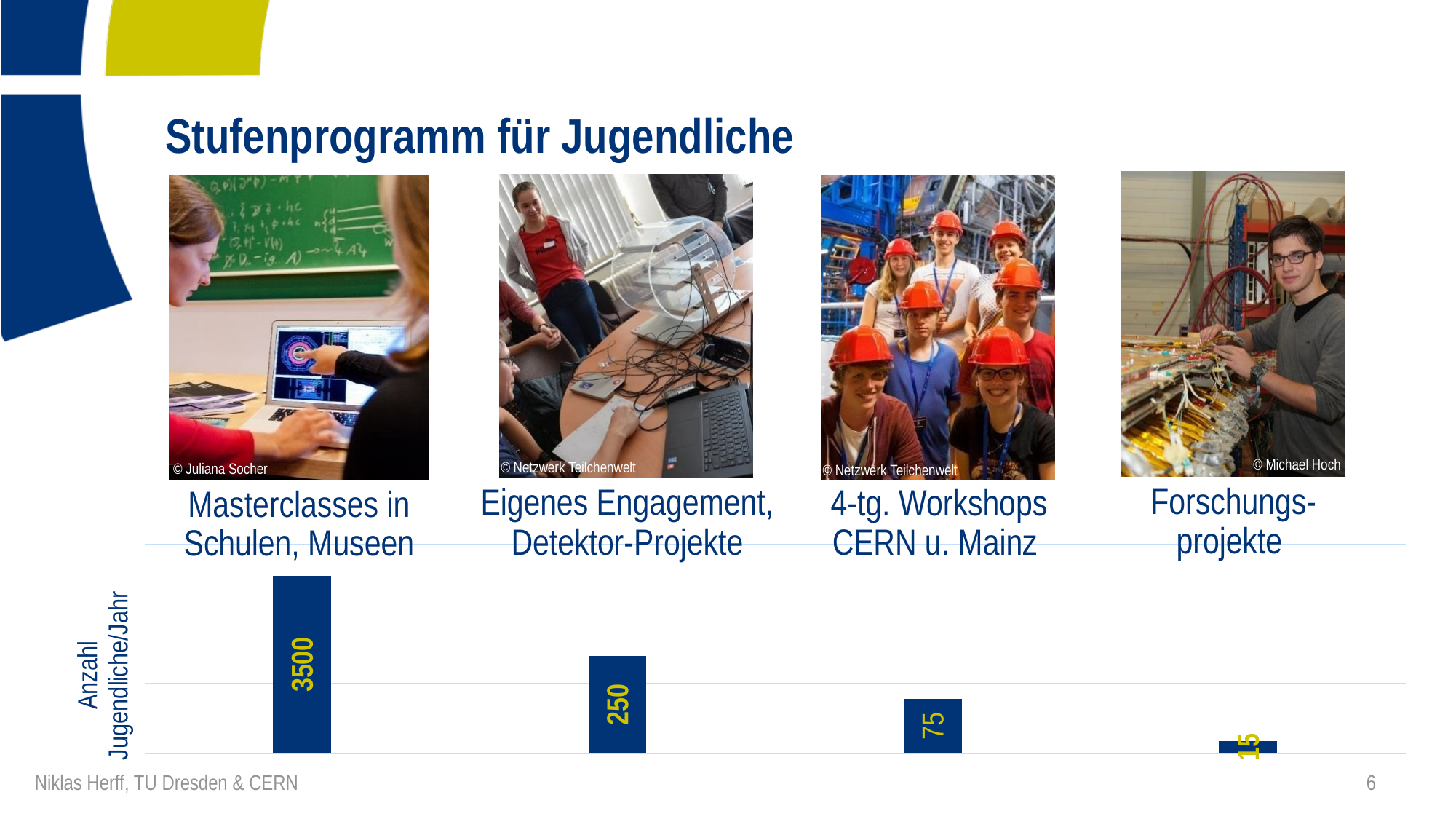
What is the value for Forschungsprojekte? 15 What is the difference between the values for 4-tg. Workshops CERN u. Mainz and Forschungsprojekte? 60 What is the difference between the values for Masterclasses in Schulen, Museen and Eigenes Engagement, Detektor-Projekte? 3250 What is the value for 4-tg. Workshops CERN u. Mainz? 75 Which is larger, the value for Eigenes Engagement, Detektor-Projekte or the value for 4-tg. Workshops CERN u. Mainz? Eigenes Engagement, Detektor-Projekte Which category has the highest value? Masterclasses in Schulen, Museen How many categories are shown in the chart? 4 What is the value for Eigenes Engagement, Detektor-Projekte? 250 Which category has the lowest value? Forschungsprojekte What kind of chart is shown on the slide? bar chart What is the value for Masterclasses in Schulen, Museen? 3500 What is the label on the vertical axis of the chart? Anzahl Jugendliche/Jahr